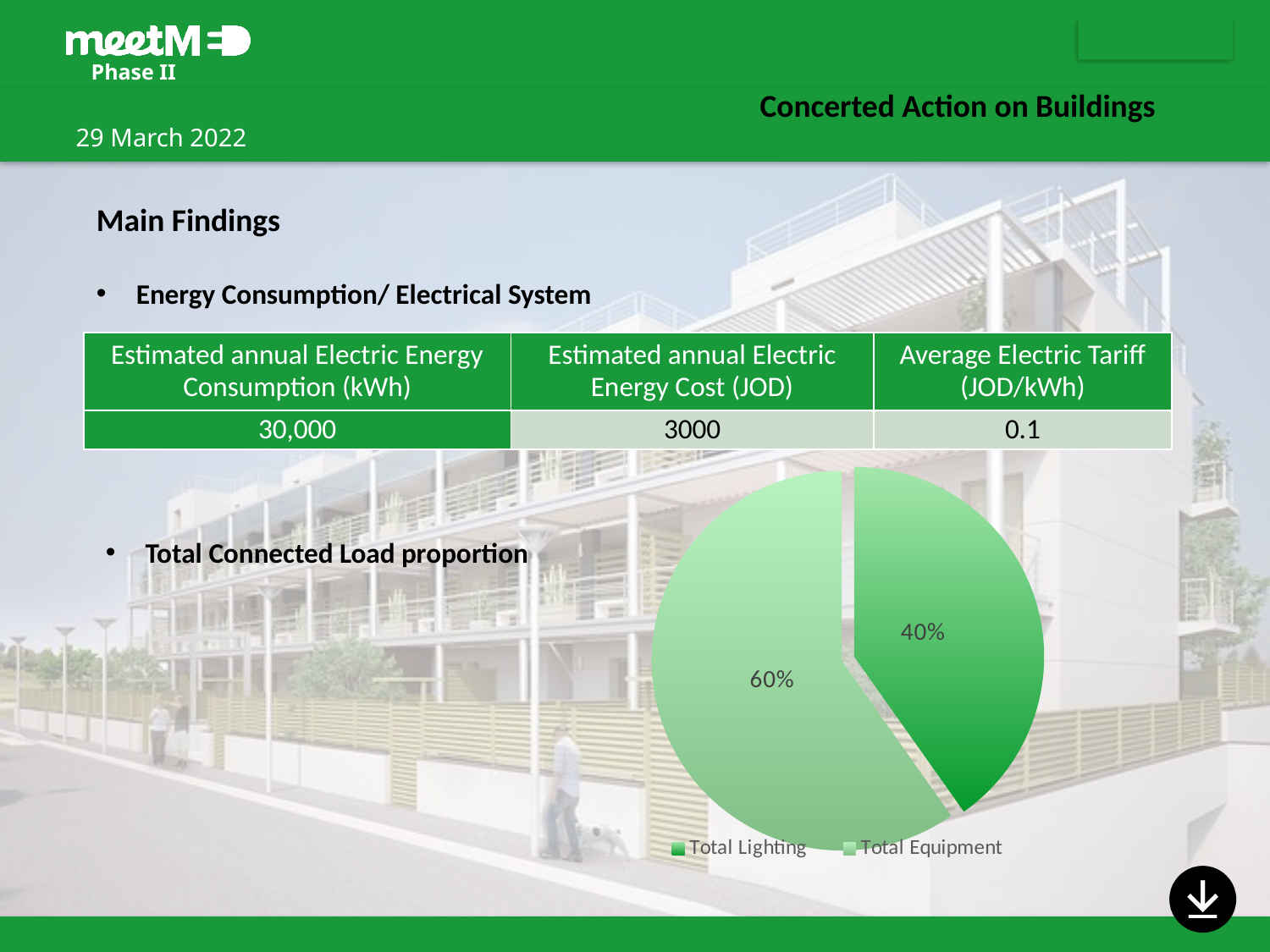
What is the difference in percentage points between the Total Equipment and Total Lighting slices? 20% Which is larger in the pie chart, Total Lighting or Total Equipment? Total Equipment What share of the pie does Total Equipment represent? 60% What share of the pie does Total Lighting represent? 40% How many slices does the pie chart have? 2 Which slice of the pie chart is the smallest? Total Lighting How many entries does the legend of the pie chart list? 2 Which slice of the pie chart is the largest? Total Equipment What are the two legend entries of the pie chart? Total Lighting and Total Equipment What does the bullet text above the pie chart say the chart shows? Total Connected Load proportion What kind of chart is shown on the slide? pie chart